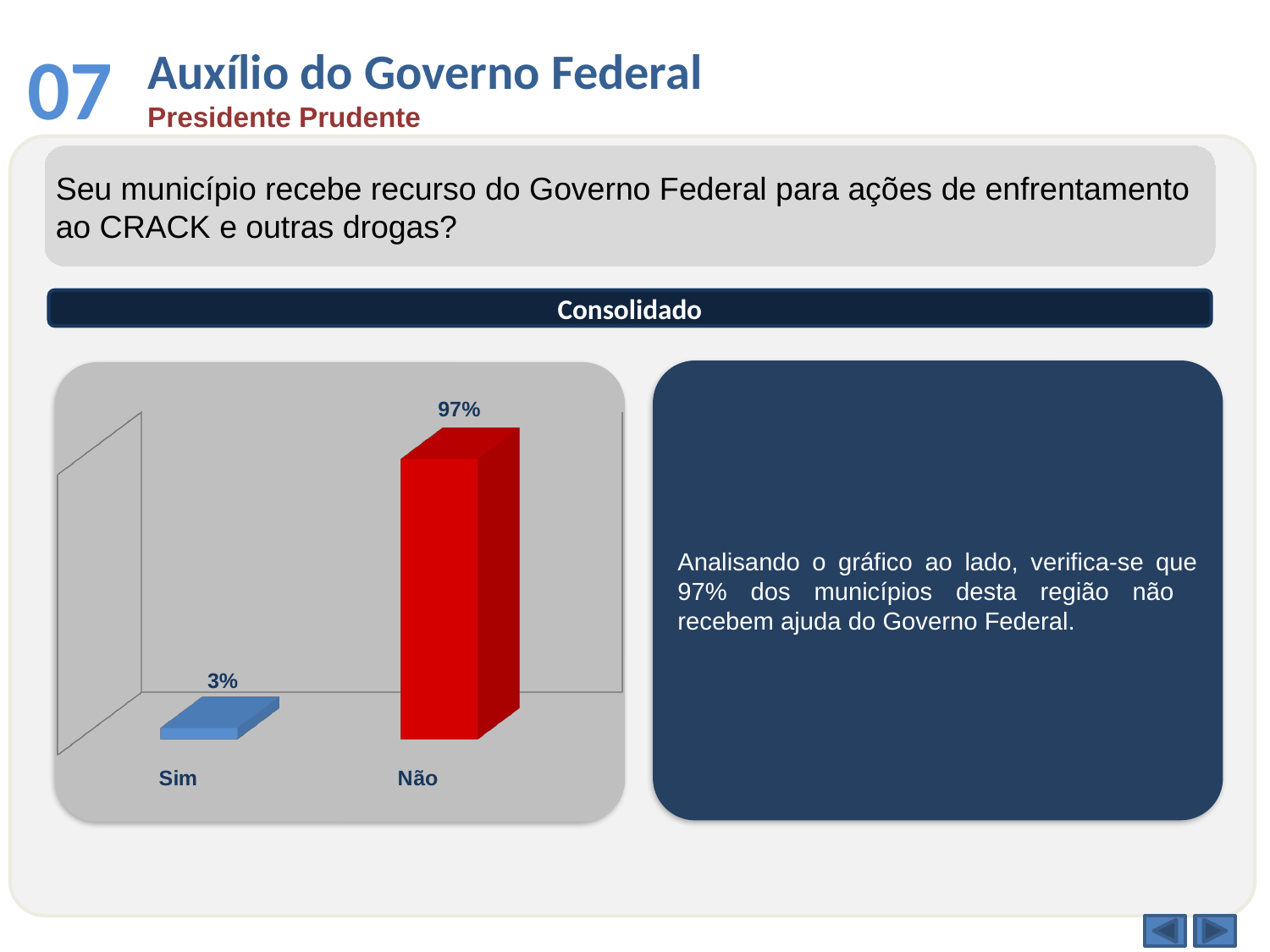
What colour is the bar for Não? Red How many categories are shown in the chart? 2 What kind of chart is shown on the slide? Bar chart What is the total of the values for Sim and Não? 100% What is the value for Sim? 3% Which category has the highest value? Não What is the value for Não? 97% What is the difference between the values for Não and Sim? 94% Which category has the lowest value? Sim Which is larger, the value for Sim or the value for Não? Não What colour is the bar for Sim? Blue